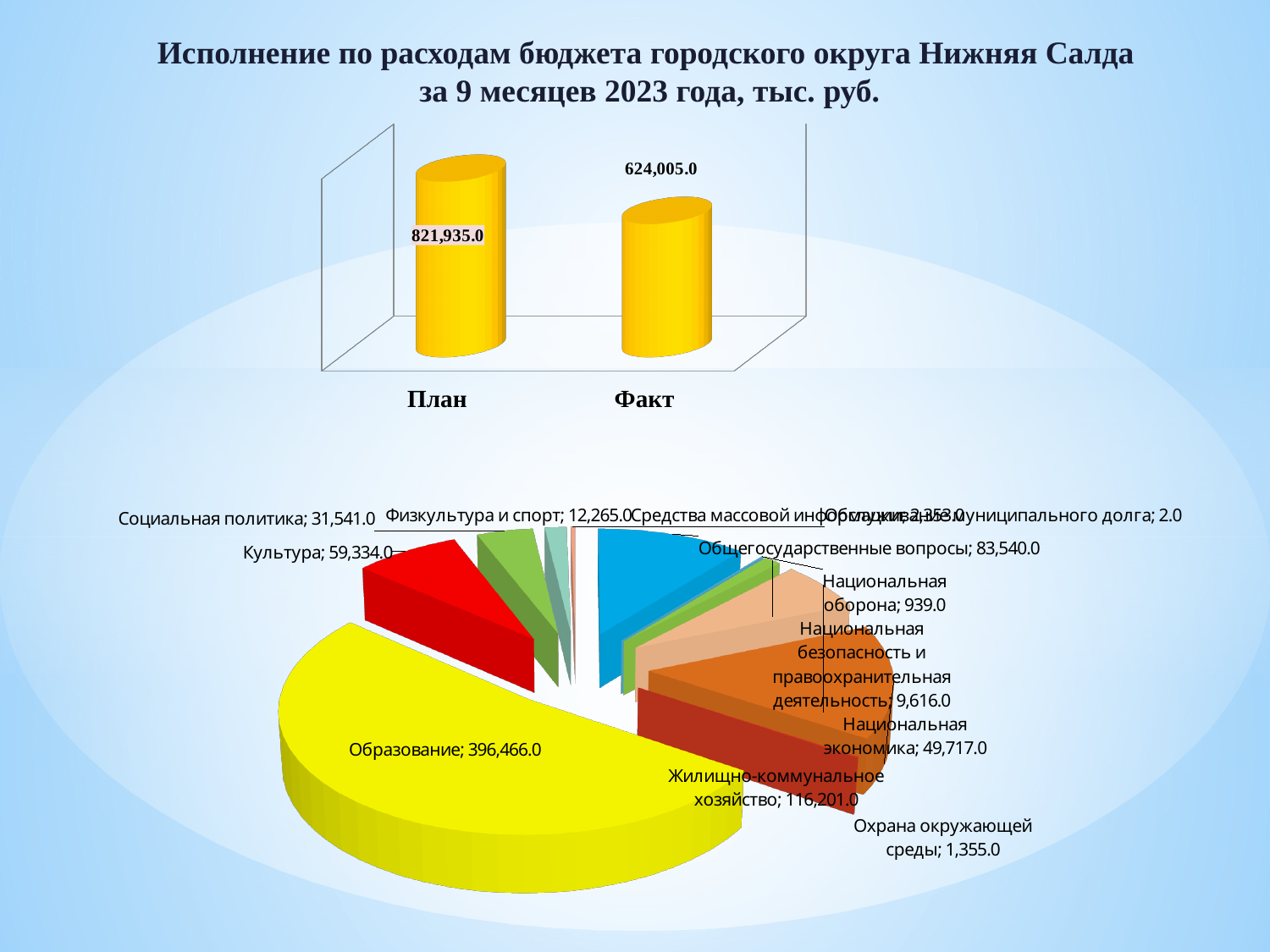
What kind of chart is the upper chart with План and Факт? bar chart In the lower pie chart, which is larger, Культура or Национальная экономика? Культура In the upper bar chart, what is the value for Факт? 624,005.0 In the lower pie chart, what is the value for Жилищно-коммунальное хозяйство? 116,201.0 How many bars does the upper chart show? 2 In the upper bar chart, what is the difference between План and Факт? 197,930.0 In the lower pie chart, what is the difference between Общегосударственные вопросы and Национальная экономика? 33,823.0 In the lower pie chart, which category has the largest value? Образование In the upper bar chart, which is larger, План or Факт? План What kind of chart is the lower chart on the slide? pie chart In the lower pie chart, what is the value for Образование? 396,466.0 In the upper bar chart, what is the value for План? 821,935.0